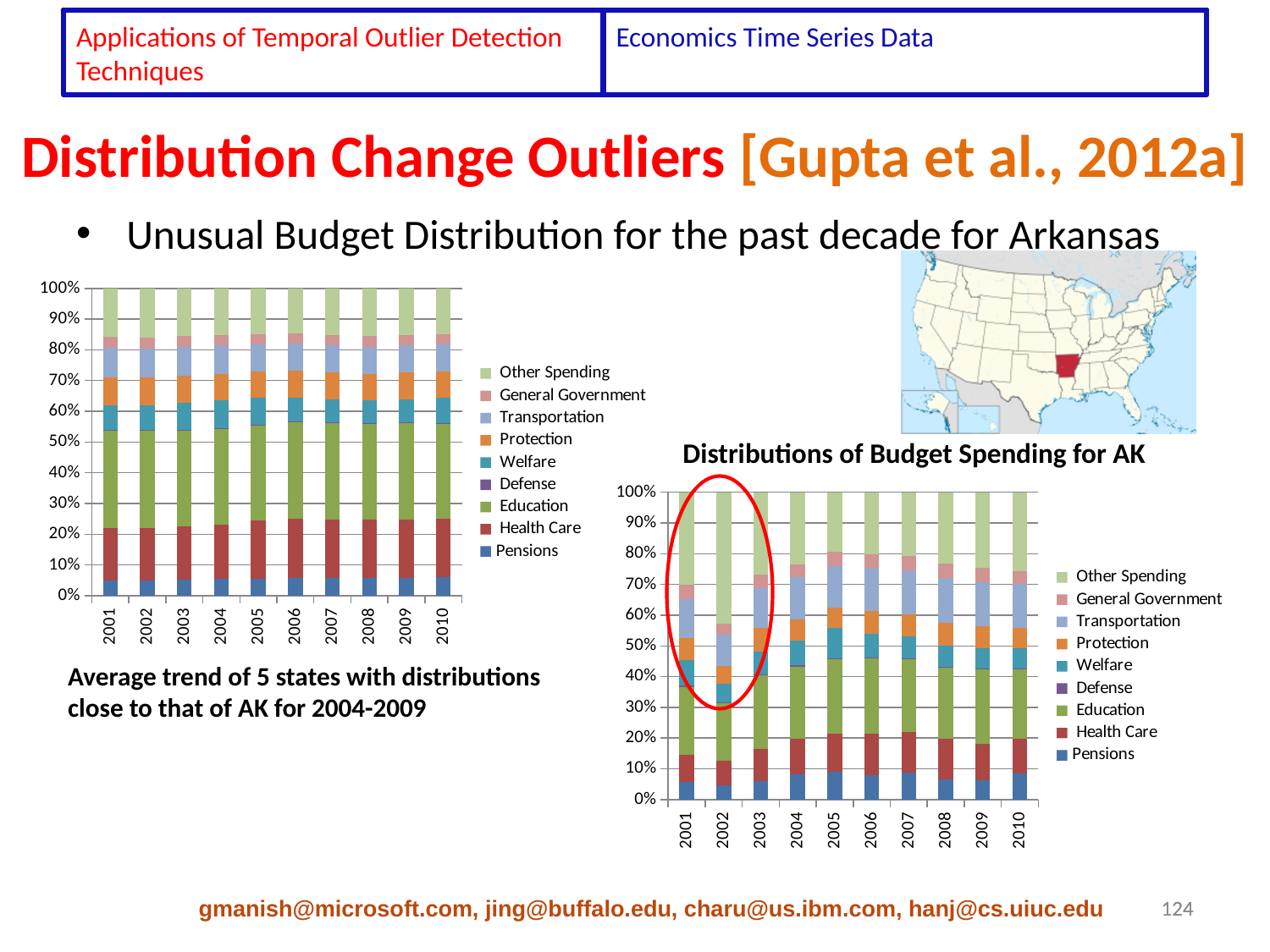
In the chart on the left of the slide, how many years are shown on the x axis? 10 What is the caption below the chart on the left of the slide? Average trend of 5 states with distributions close to that of AK for 2004-2009 In the chart titled "Distributions of Budget Spending for AK", is the Other Spending share in 2005 greater or less than 30%? less In the chart on the left of the slide, which is larger in 2001: the Education share or the Other Spending share? Education In the chart titled "Distributions of Budget Spending for AK", how many years are shown on the x axis? 10 In the chart titled "Distributions of Budget Spending for AK", is the Other Spending share in 2002 greater or less than 30%? greater How many series does the legend of the chart on the left of the slide list? 9 In the chart titled "Distributions of Budget Spending for AK", is the Other Spending share in 2002 larger or smaller than in 2005? larger What kind of chart is the chart titled "Distributions of Budget Spending for AK"? stacked bar chart What kind of chart is the chart on the left of the slide? stacked bar chart How many series does the legend of the chart titled "Distributions of Budget Spending for AK" list? 9